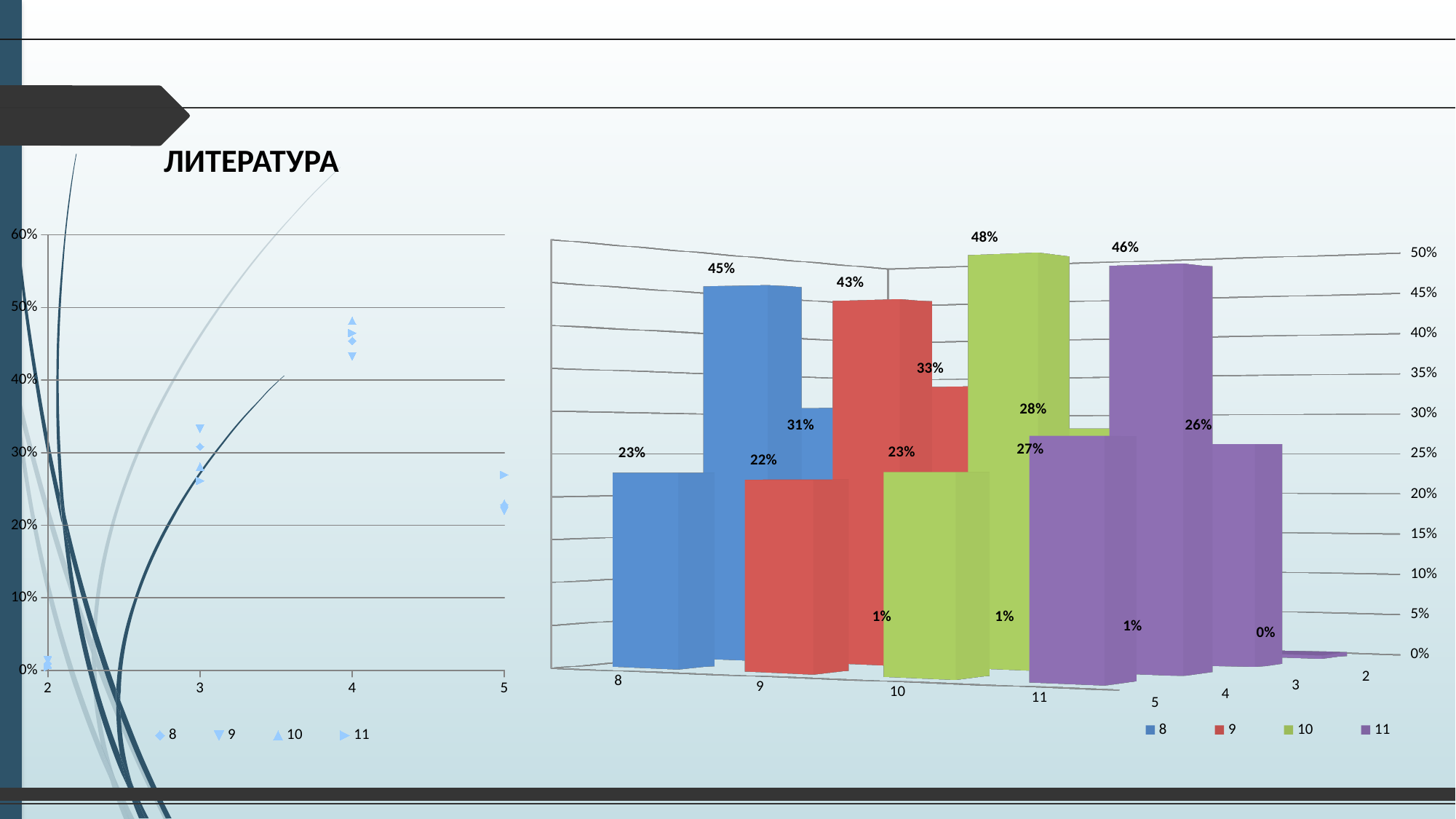
In the bar chart on the right, what is the value for series 11 at category 4? 46% In the bar chart on the right, what is the highest data label shown? 48% What kind of chart is the chart on the right side of the slide? bar chart In the bar chart on the right, what is the value for series 8 at category 4? 45% What kind of chart is the chart on the left side of the slide? scatter chart In the scatter chart on the left, how many series does the legend list? 4 In the bar chart on the right, which is larger at category 3: series 8 (31%) or series 9 (33%)? series 9 In the bar chart on the right, what is the difference between the value for series 10 at category 4 (48%) and the value for series 11 at category 4 (46%)? 2% In the bar chart on the right, how many series does the legend list? 4 In the bar chart on the right, what is the value for series 9 at category 4? 43% In the bar chart on the right, which series has the bar labelled 48%? 10 What is the title shown on the slide above the charts? ЛИТЕРАТУРА